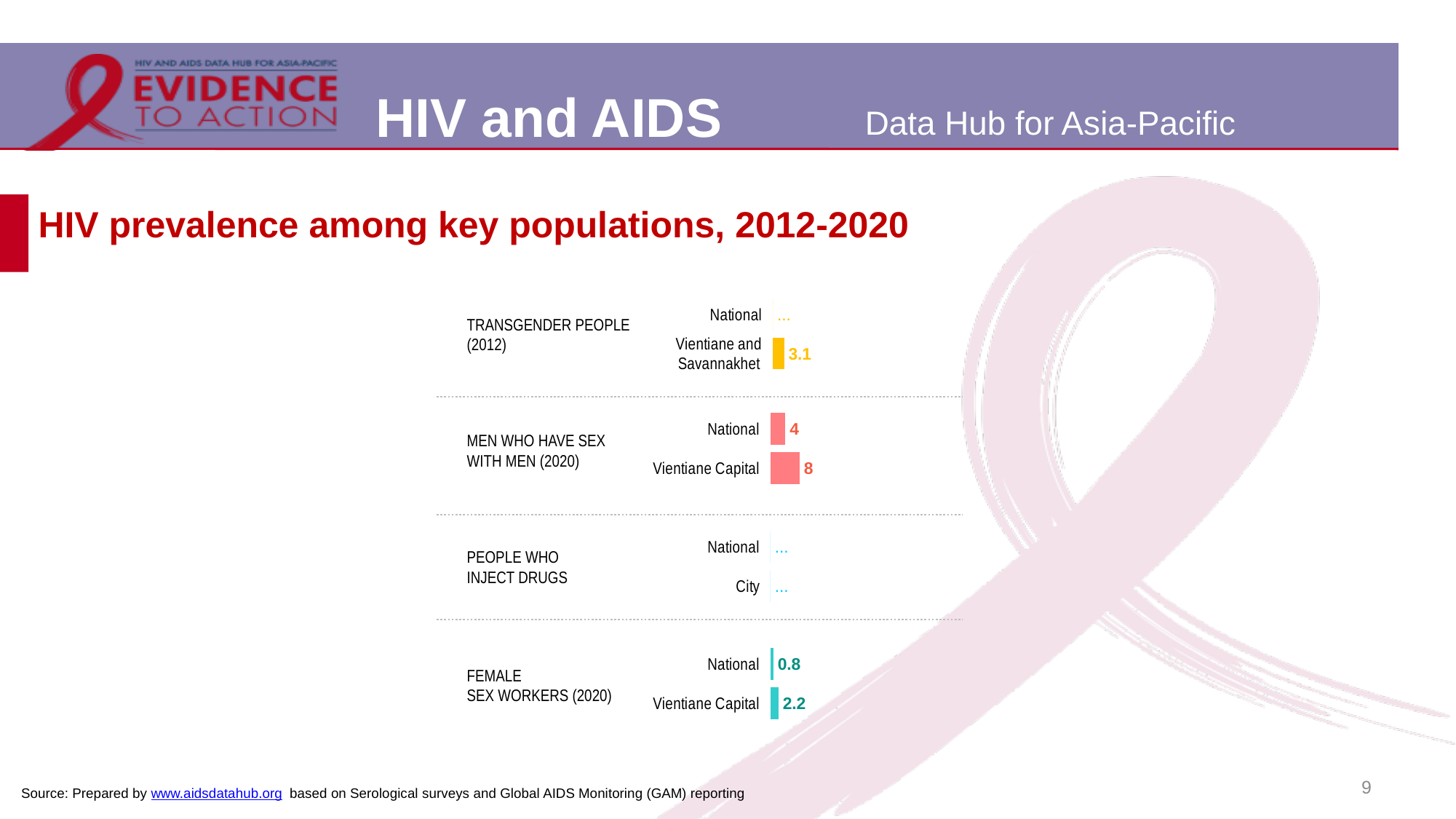
What is the difference between the Vientiane Capital and national HIV prevalence values for men who have sex with men (2020)? 4 Which is larger: the HIV prevalence among female sex workers in Vientiane Capital or among transgender people in Vientiane and Savannakhet? Transgender people in Vientiane and Savannakhet What type of chart is used to show HIV prevalence among key populations? Bar chart Which key population and location has the highest HIV prevalence value shown on the chart? Men who have sex with men (2020), Vientiane Capital What is the HIV prevalence among female sex workers (2020) at the national level? 0.8 What is the HIV prevalence among men who have sex with men (2020) at the national level? 4 What is the difference between the Vientiane Capital and national HIV prevalence values for female sex workers (2020)? 1.4 Which key population and location has the lowest HIV prevalence value shown on the chart? Female sex workers (2020), National What is the HIV prevalence among female sex workers (2020) in Vientiane Capital? 2.2 What is the HIV prevalence among men who have sex with men (2020) in Vientiane Capital? 8 What is the HIV prevalence among transgender people (2012) in Vientiane and Savannakhet? 3.1 How many key population groups are shown on the chart? 4